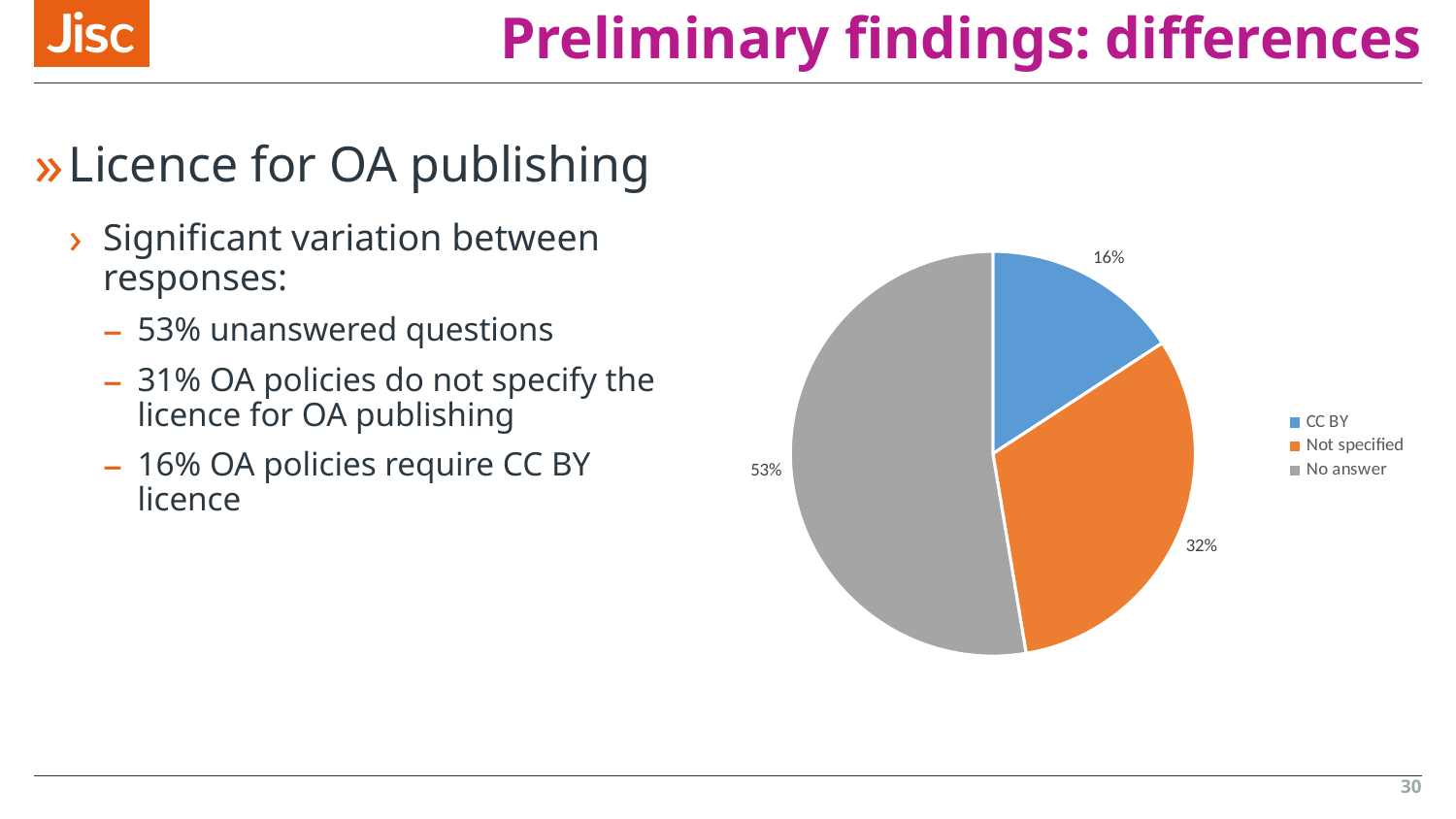
How many entries does the legend list? 3 Which category has the largest slice of the pie? No answer What is the difference in percentage points between the No answer slice and the Not specified slice? 21 How many categories does the pie chart show? 3 What share of the pie does the CC BY slice represent? 16% Which category has the smallest slice of the pie? CC BY What share of the pie does the Not specified slice represent? 32% What kind of chart is shown on the slide? pie chart What is the difference in percentage points between the Not specified slice and the CC BY slice? 16 Which is larger, the Not specified slice or the CC BY slice? Not specified What share of the pie does the No answer slice represent? 53% What colour is the No answer slice in the pie chart? grey